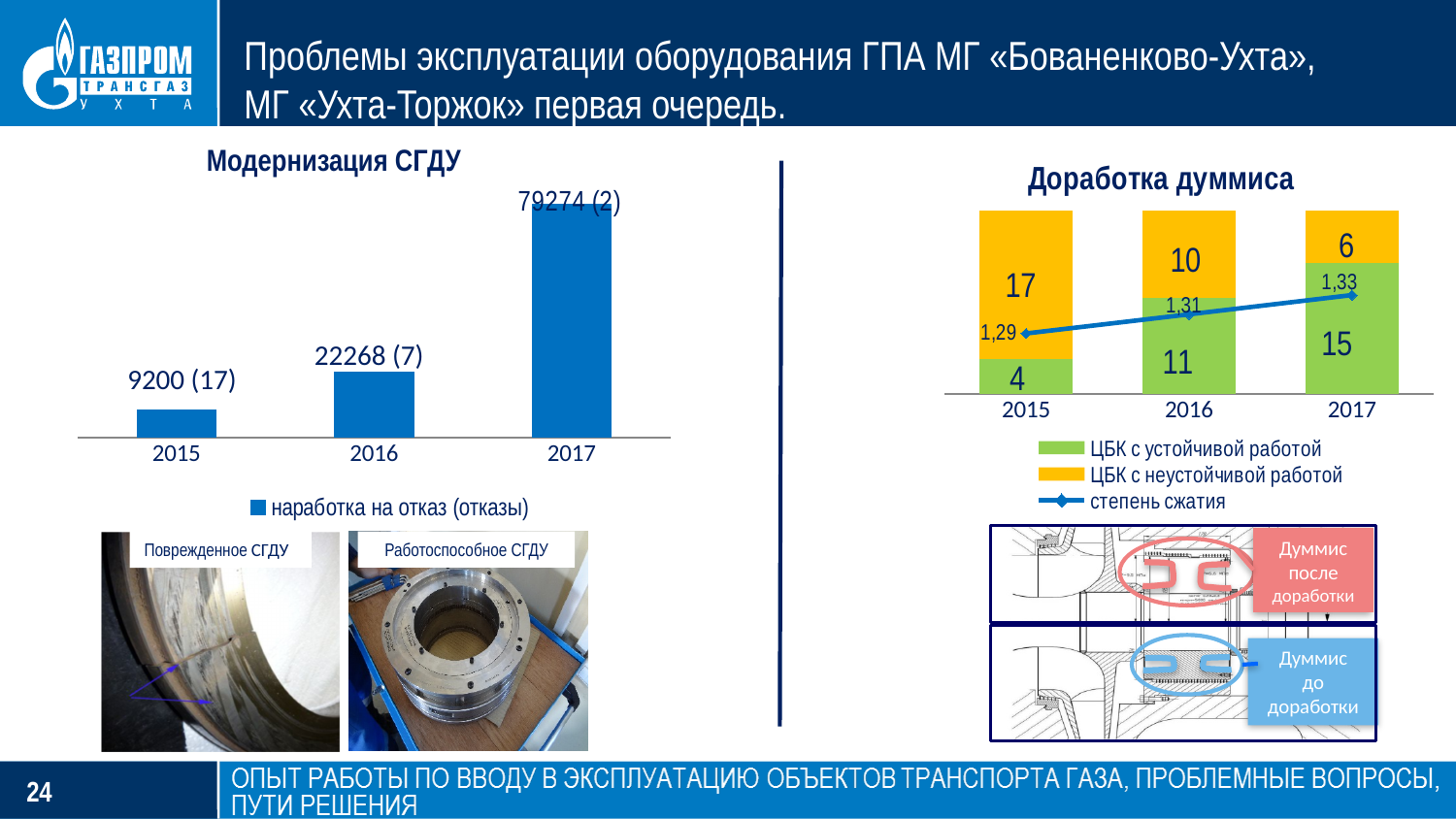
On the «Модернизация СГДУ» chart, do the values rise or fall from 2015 to 2017? rise On the «Доработка думмиса» chart, what is the «степень сжатия» value for 2017? 1,33 On the «Доработка думмиса» chart, which year has the lowest value of «ЦБК с неустойчивой работой»? 2017 What type of chart is «Модернизация СГДУ»? bar chart On the «Модернизация СГДУ» chart, how many bars are plotted? 3 On the «Доработка думмиса» chart, what is the value of «ЦБК с неустойчивой работой» for 2015? 17 On the «Модернизация СГДУ» chart, what is the data label for 2015? 9200 (17) On the «Модернизация СГДУ» chart, which year has the highest bar? 2017 On the «Доработка думмиса» chart, what is the total of the stacked bar for 2017? 21 On the «Доработка думмиса» chart, how many series does the legend list? 3 On the «Модернизация СГДУ» chart, what is the data label for 2016? 22268 (7) On the «Доработка думмиса» chart, what is the value of «ЦБК с устойчивой работой» for 2016? 11